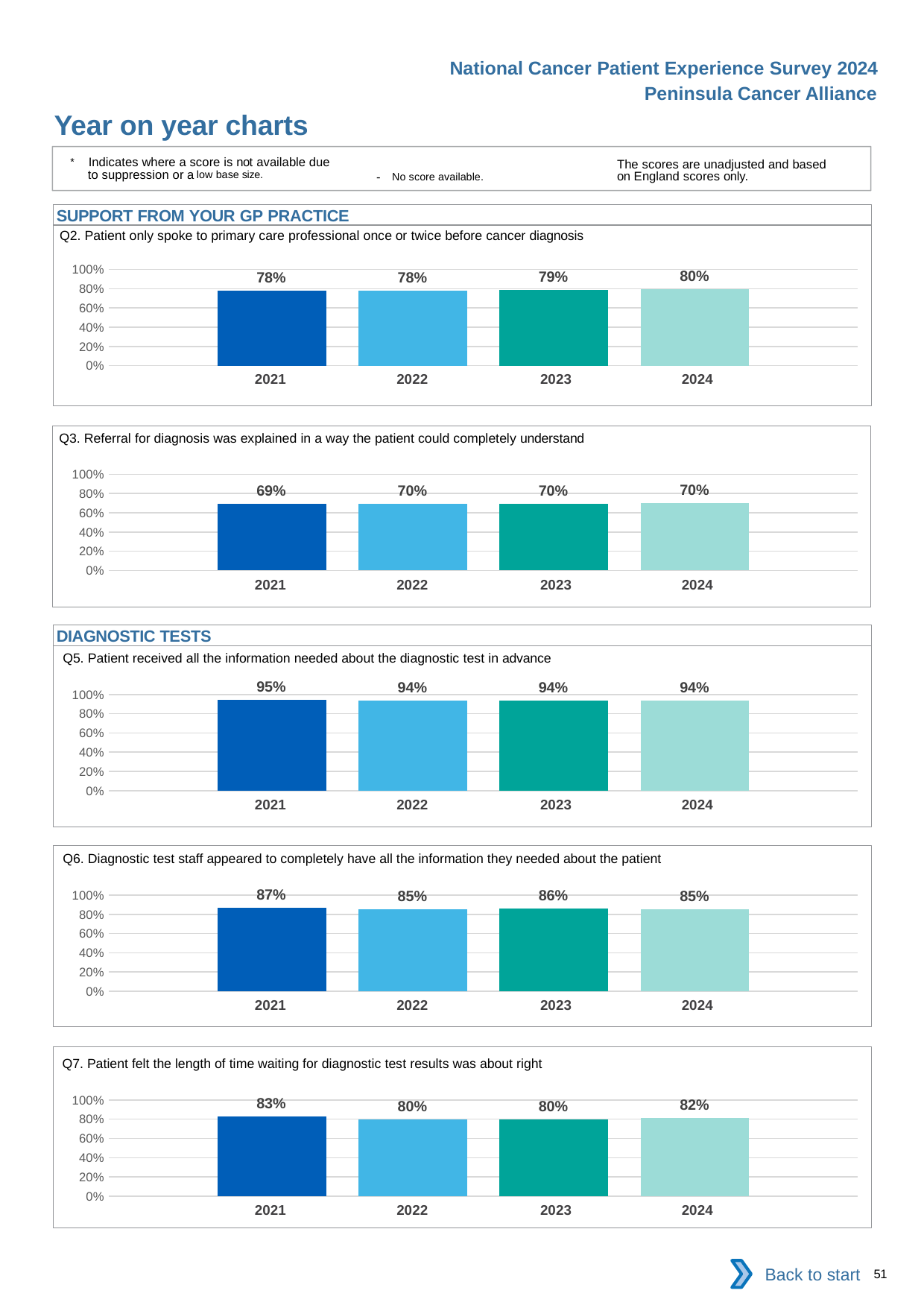
In the Q2 chart, which year has the lowest value? 2021 and 2022 (both 78%) In the Q6 chart, what is the difference between the 2021 value and the 2024 value? 2 percentage points In the Q3 chart, what is the difference between the 2022 value and the 2021 value? 1 percentage point In the Q5 chart, what is the value for 2023? 94% What type of chart is used for Q2? Bar chart In the Q3 chart (referral for diagnosis was explained in a way the patient could completely understand), what is the value for 2021? 69% In the Q7 chart, is the value for 2024 larger or smaller than the value for 2023? larger In the Q6 chart (diagnostic test staff appeared to completely have all the information they needed about the patient), what is the value for 2021? 87% How many years are shown on the x axis of the Q7 chart? 4 In the Q7 chart (patient felt the length of time waiting for diagnostic test results was about right), which year has the highest value? 2021 In the Q5 chart (patient received all the information needed about the diagnostic test in advance), which year has the highest value? 2021 In the Q2 chart (patient only spoke to primary care professional once or twice before cancer diagnosis), what is the value for 2024? 80%